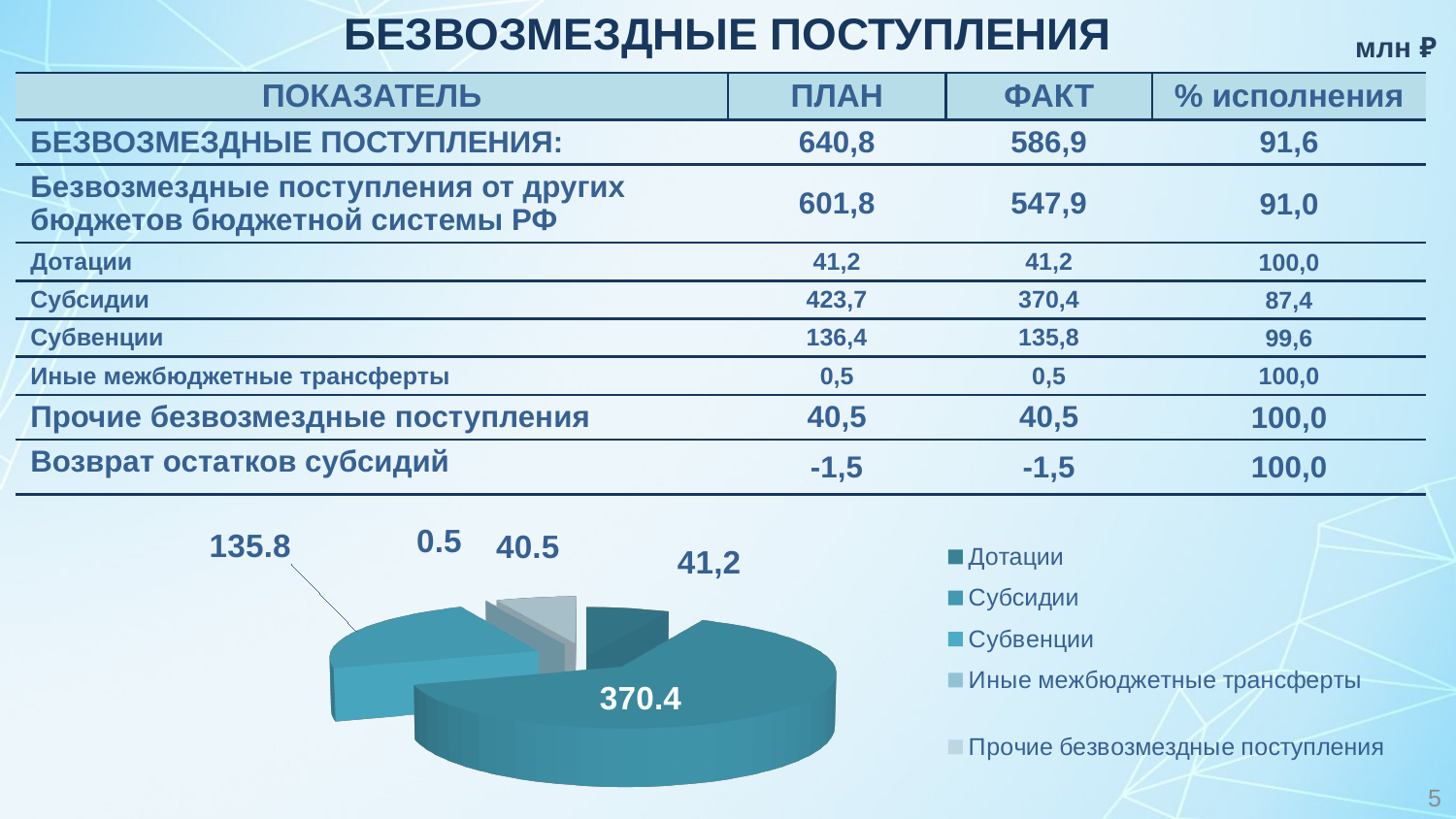
In the pie chart, what is the value of the Субвенции slice? 135.8 How many categories does the legend of the pie chart list? 5 In the pie chart, what is the value of the Субсидии slice? 370.4 In the pie chart, what is the value of the Иные межбюджетные трансферты slice? 0.5 Which category has the smallest slice in the pie chart? Иные межбюджетные трансферты In the pie chart, what is the difference between the Субсидии value and the Субвенции value? 234.6 Which legend entry in the pie chart is listed first? Дотации In the pie chart, which is larger: Субвенции or Прочие безвозмездные поступления? Субвенции In the pie chart, what is the value of the Прочие безвозмездные поступления slice? 40.5 What kind of chart is shown at the bottom of the slide? pie chart Which category has the largest slice in the pie chart? Субсидии In the pie chart, what is the value of the Дотации slice? 41,2